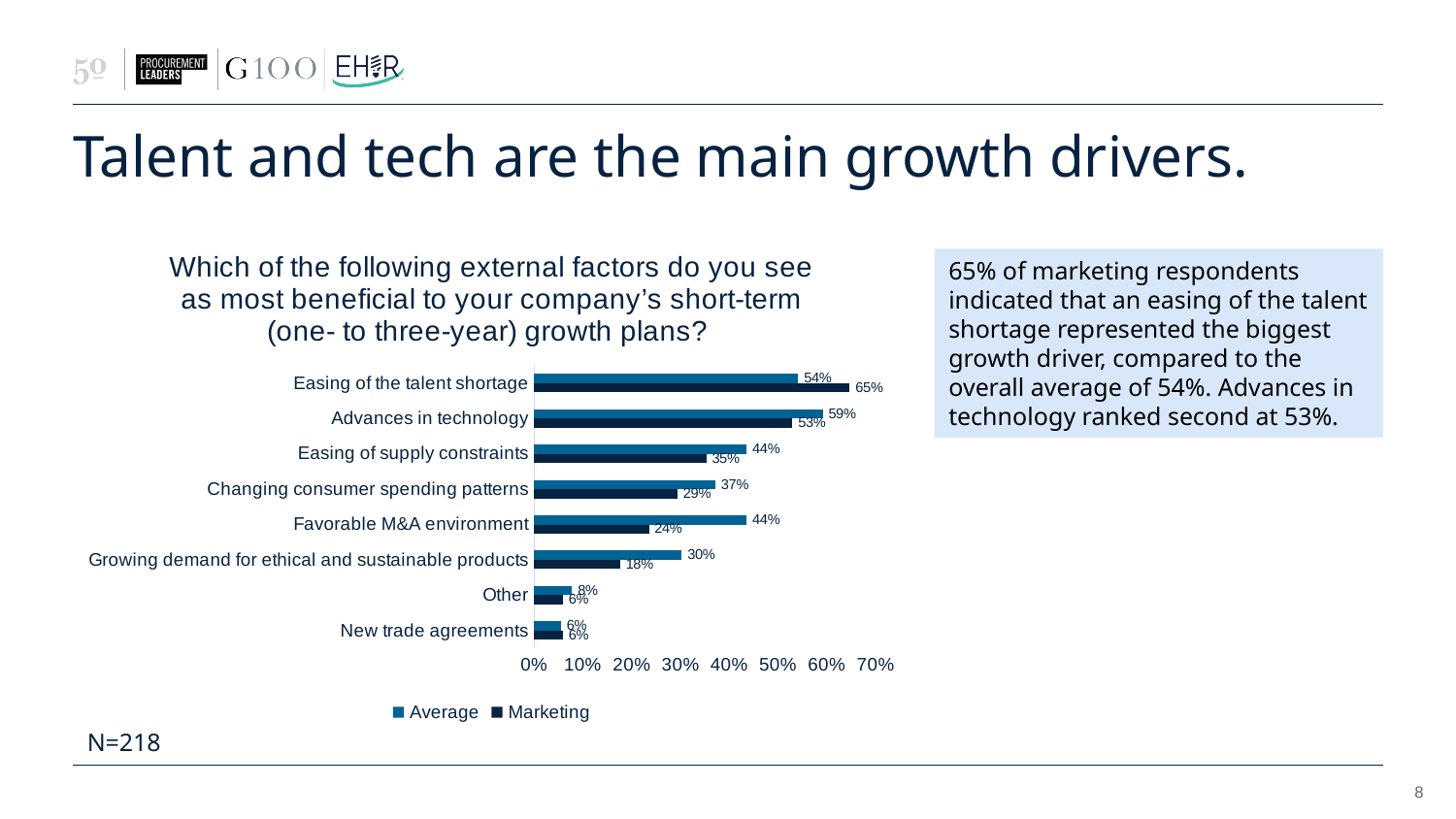
What is the Average value for Easing of the talent shortage? 54% How many series does the legend list? 2 What is the difference between the Marketing and Average values for Easing of the talent shortage? 11% What is the Marketing value for Easing of the talent shortage? 65% Which category has the highest Average value? Advances in technology How many categories are shown on the chart? 8 What kind of chart is shown on the slide? Bar chart Which category has the lowest Average value? New trade agreements Which category has the highest Marketing value? Easing of the talent shortage What is the Marketing value for Favorable M&A environment? 24% Which is larger for Advances in technology, the Average value or the Marketing value? Average What is the Average value for Growing demand for ethical and sustainable products? 30%